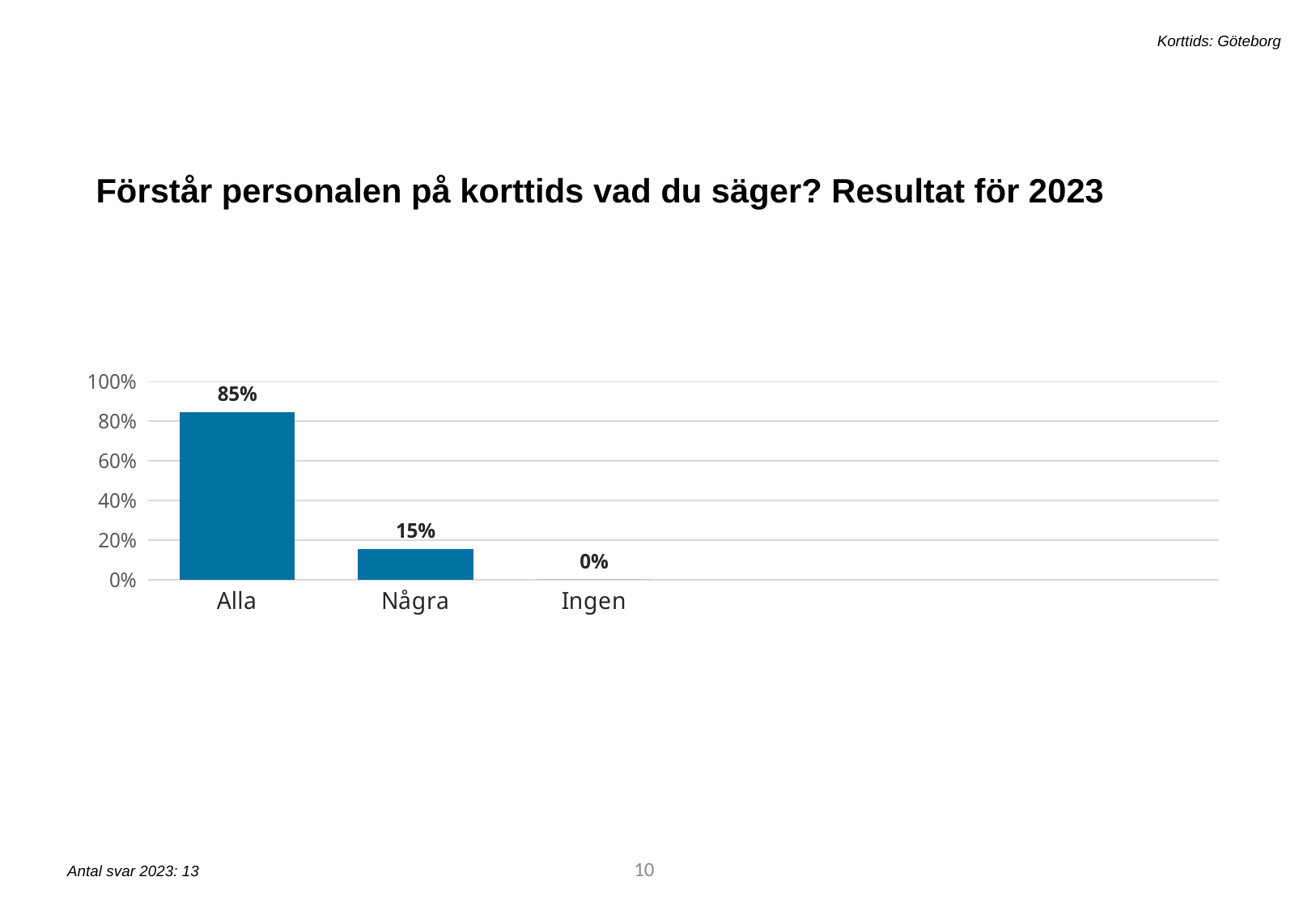
Which category has the lowest value? Ingen What is the value for Några? 15% What is the value for Alla? 85% Which is larger, the value for Några or the value for Ingen? Några Do the values rise or fall from left to right along the x axis? fall Is the value for Alla greater or less than 60%? greater What is the value for Ingen? 0% How many categories are shown on the x axis? 3 What kind of chart is shown on the slide? bar chart Is the value for Några greater or less than 40%? less What is the difference between the values for Alla and Några? 70% Which category has the highest value? Alla